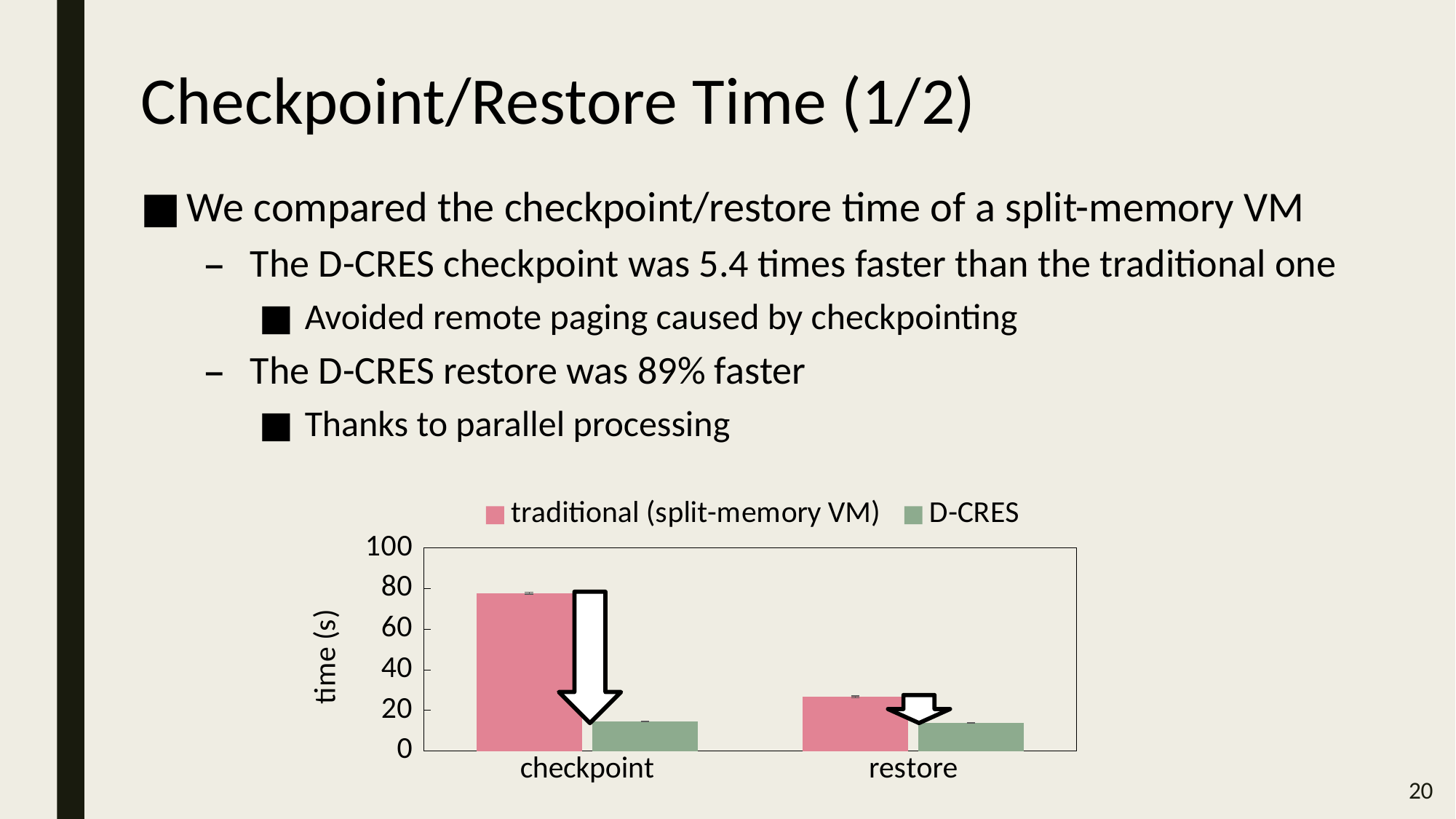
How many categories are shown on the x axis of the chart? 2 Is the traditional (split-memory VM) checkpoint time greater or less than 60? greater What is the label of the y axis of the chart? time (s) Is the traditional (split-memory VM) restore time greater or less than 20? greater For restore, which series has the larger time: traditional (split-memory VM) or D-CRES? traditional (split-memory VM) For the traditional (split-memory VM) series, which is larger: the checkpoint time or the restore time? checkpoint Which bar in the chart is the highest? traditional (split-memory VM) for checkpoint How many series does the chart legend list? 2 Is the traditional (split-memory VM) restore time greater or less than 40? less What kind of chart is shown on the slide? bar chart For checkpoint, which series has the larger time: traditional (split-memory VM) or D-CRES? traditional (split-memory VM)